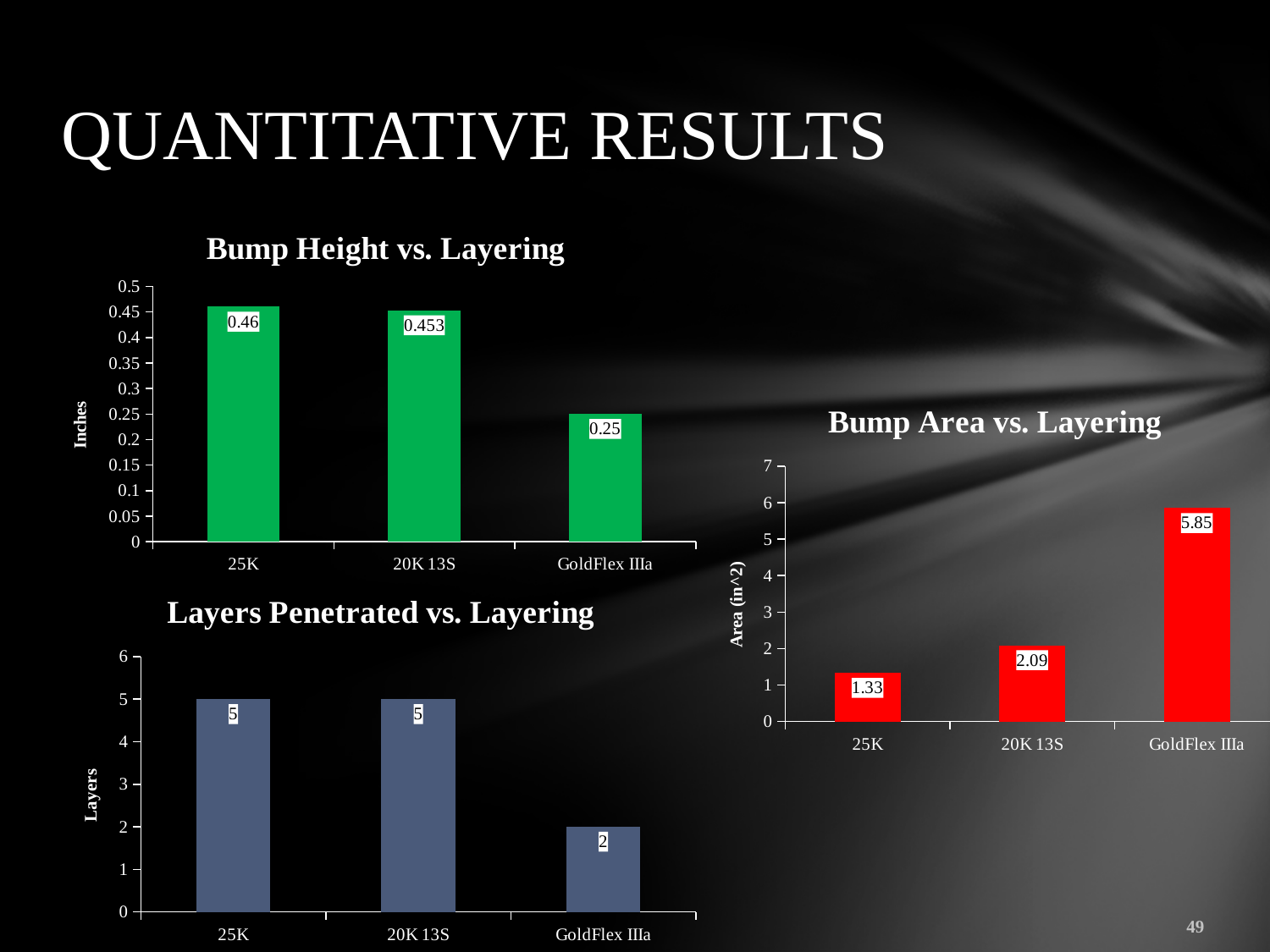
In the 'Bump Height vs. Layering' chart, what is the value for 25K? 0.46 In the 'Bump Height vs. Layering' chart, what is the value for GoldFlex IIIa? 0.25 In the 'Layers Penetrated vs. Layering' chart, what is the value for GoldFlex IIIa? 2 What kind of chart is the 'Bump Area vs. Layering' chart? bar chart In the 'Bump Area vs. Layering' chart, what is the difference between the values for GoldFlex IIIa and 25K? 4.52 In the 'Layers Penetrated vs. Layering' chart, how many categories are shown on the x axis? 3 In the 'Layers Penetrated vs. Layering' chart, what is the difference between the values for 25K and GoldFlex IIIa? 3 In the 'Bump Height vs. Layering' chart, which category has the lowest value? GoldFlex IIIa In the 'Bump Area vs. Layering' chart, do the values rise or fall from left to right along the x axis? rise In the 'Bump Area vs. Layering' chart, what is the value for 20K 13S? 2.09 In the 'Bump Height vs. Layering' chart, what is the difference between the values for 25K and 20K 13S? 0.007 In the 'Bump Area vs. Layering' chart, which category has the highest value? GoldFlex IIIa